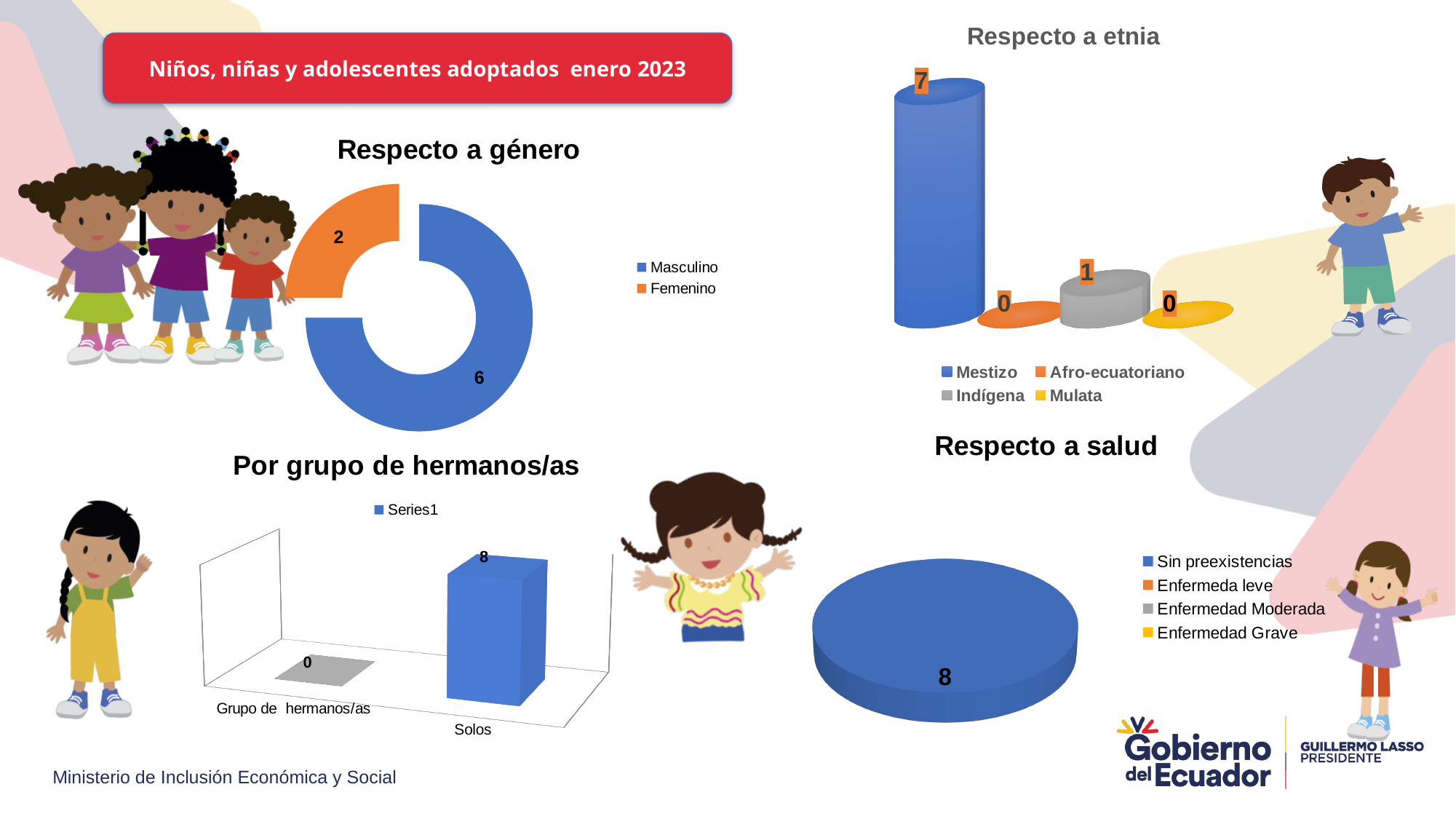
In the 'Por grupo de hermanos/as' chart, what is the value for Solos? 8 What kind of chart is 'Respecto a salud'? Pie chart In the 'Respecto a género' chart, what is the difference between the Masculino and Femenino values? 4 In the 'Respecto a etnia' chart, what is the value for Indígena? 1 In the 'Respecto a género' chart, what share of the total does Masculino represent? 75% In the 'Respecto a etnia' chart, how many categories does the legend list? 4 In the 'Por grupo de hermanos/as' chart, what is the value for Grupo de hermanos/as? 0 In the 'Respecto a género' chart, what is the value for Masculino? 6 In the 'Respecto a etnia' chart, which category has the highest value? Mestizo In the 'Respecto a género' chart, what is the value for Femenino? 2 In the 'Respecto a etnia' chart, what is the value for Mestizo? 7 In the 'Respecto a salud' chart, what value is printed on the Sin preexistencias slice? 8